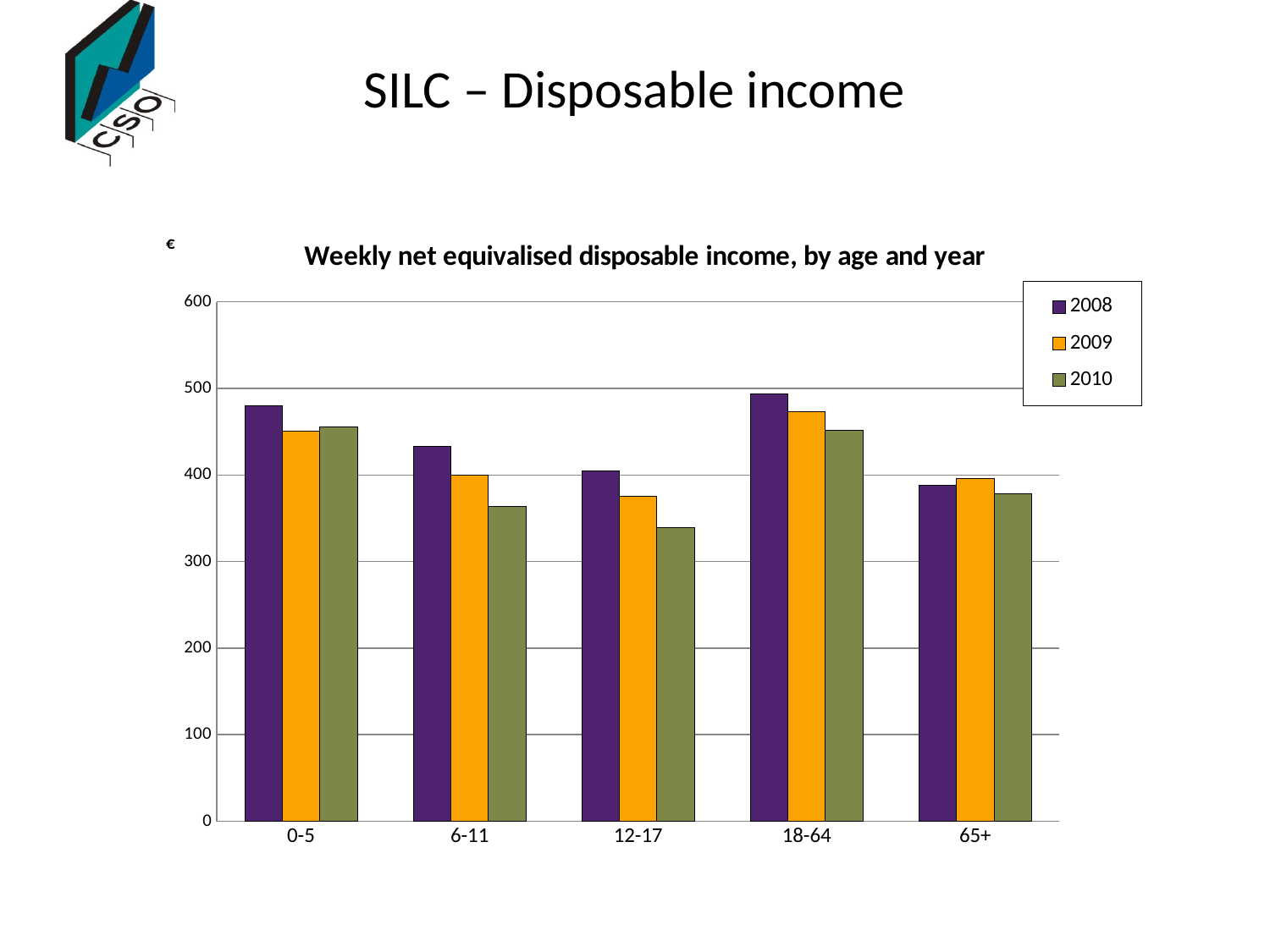
Which age group has the highest value for 2008? 18-64 How many series does the legend list? 3 For the 12-17 age group, which is larger: the 2008 value or the 2010 value? 2008 Which age group has the lowest value for 2008? 65+ What kind of chart is shown on the slide? bar chart Which age group has the lowest value for 2010? 12-17 Is the value for 2008 in the 18-64 age group greater or less than 400? greater Is the value for 2010 in the 12-17 age group greater or less than 400? less Is the value for 2010 in the 6-11 age group greater or less than 400? less How many age groups are shown on the x axis? 5 For the 6-11 age group, do the values rise or fall from 2008 to 2010? fall What is the title of the chart? Weekly net equivalised disposable income, by age and year